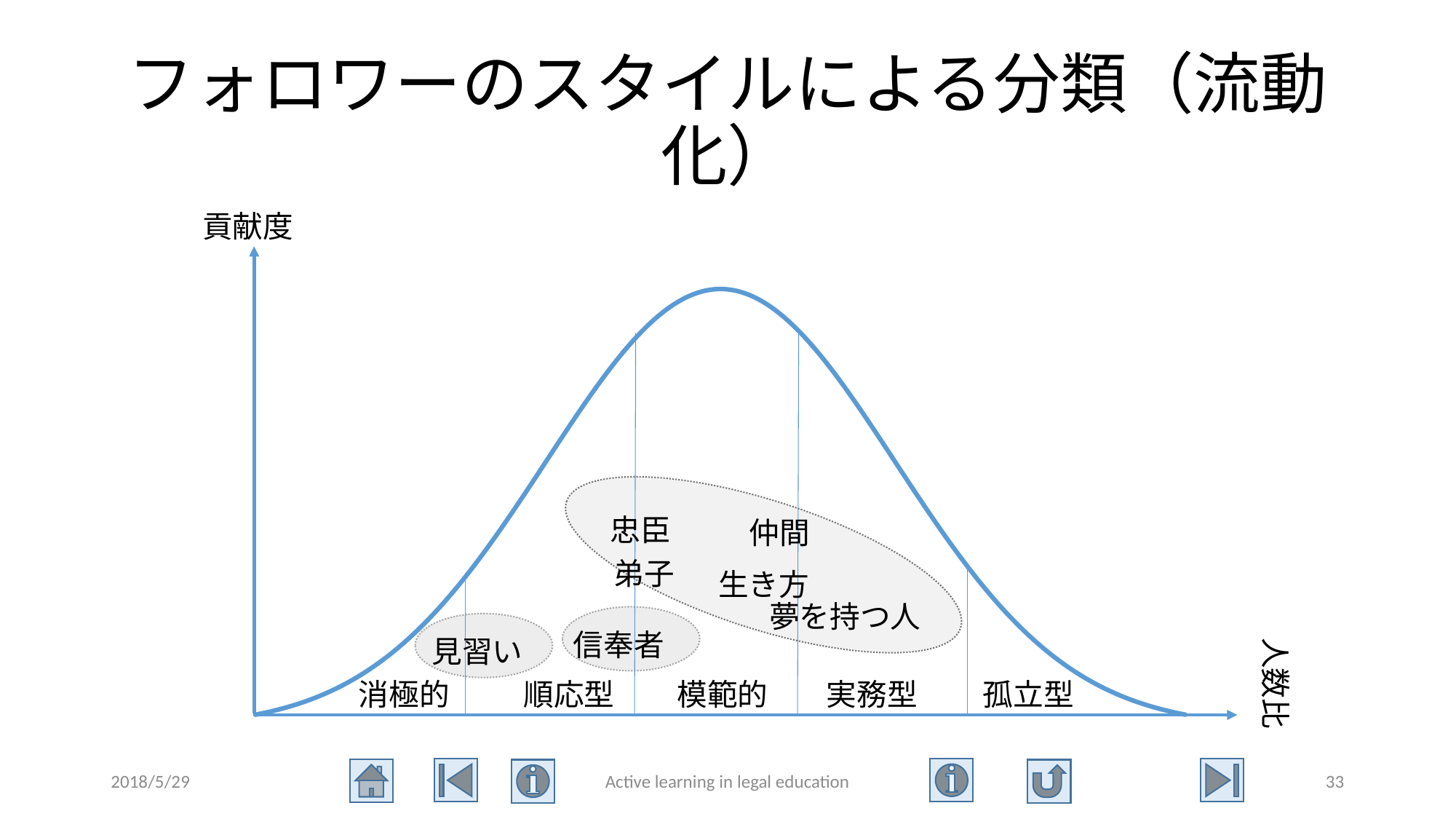
What is the label on the vertical axis? 貢献度 Is the curve higher in the 順応型 segment or the 消極的 segment? 順応型 Is the curve higher in the 模範的 segment or the 孤立型 segment? 模範的 Does the curve rise or fall moving from 模範的 to 孤立型 along the x axis? Falls Does the curve rise or fall moving from 消極的 to 模範的 along the x axis? Rises In which x-axis category does the peak of the curve fall? 模範的 How many follower categories are labelled along the x axis? 5 Which category label is rightmost on the x axis? 孤立型 What is the label on the horizontal axis? 人数比 What kind of chart is shown on the slide? A bell curve (normal distribution curve) Which category label is leftmost on the x axis? 消極的